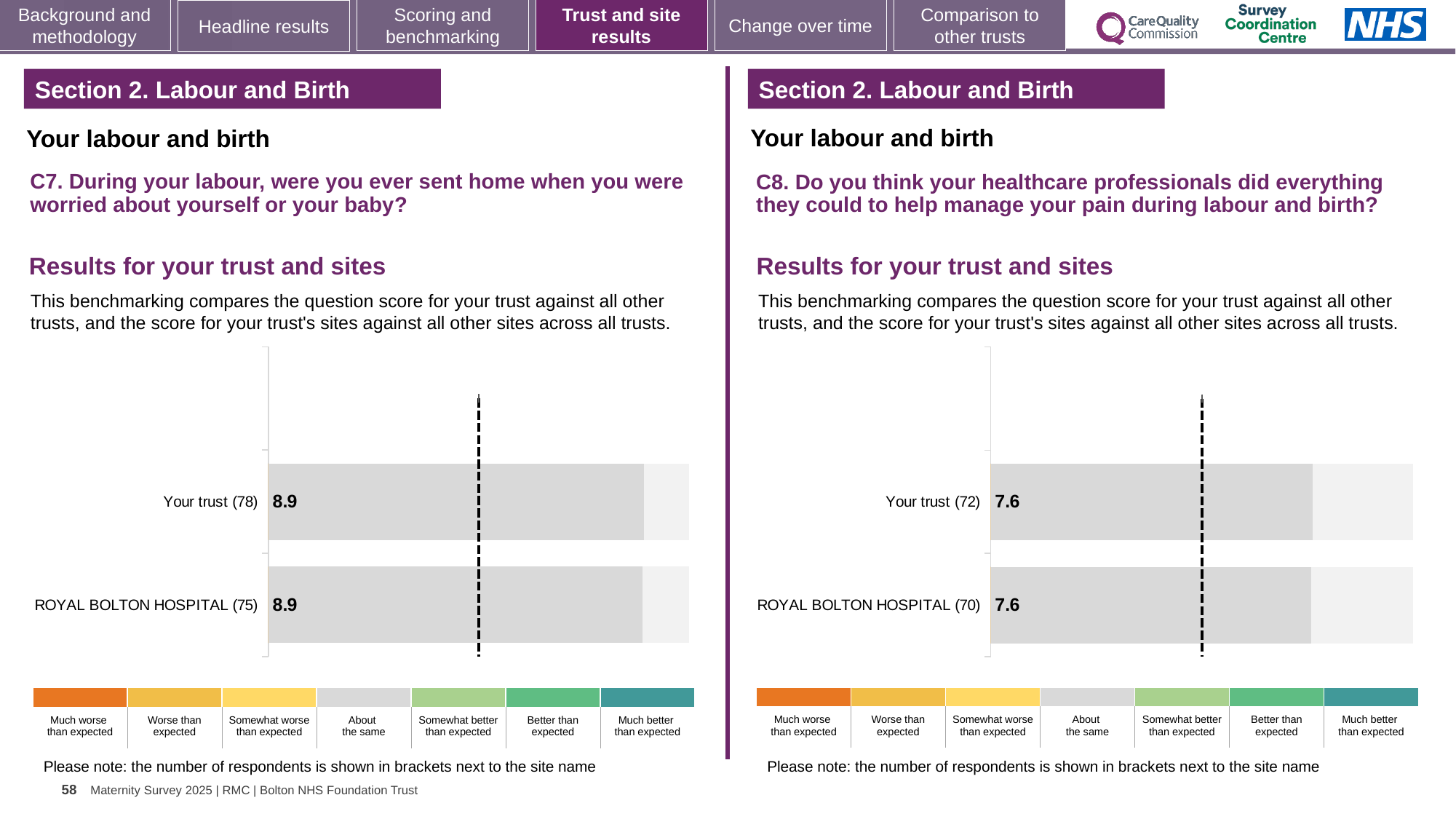
In the C8 chart on the right, what is the difference between the Your trust score and the ROYAL BOLTON HOSPITAL score? 0 How many bars are plotted in the C8 chart on the right? 2 In the C8 chart on the right, what is the score for Your trust? 7.6 In the C8 chart on the right, how many respondents are shown in brackets for Your trust? 72 In the C8 chart on the right, what is the score for ROYAL BOLTON HOSPITAL? 7.6 What type of chart is used for the C7 results on the left? Bar chart In the C7 chart on the left, what is the score for ROYAL BOLTON HOSPITAL? 8.9 In the C7 chart on the left, how many respondents are shown in brackets for ROYAL BOLTON HOSPITAL? 75 In the C7 chart on the left, what is the score for Your trust? 8.9 Is the Your trust score in the C7 chart on the left larger or smaller than the Your trust score in the C8 chart on the right? Larger How many bars are plotted in the C7 chart on the left? 2 In the C7 chart on the left, what is the difference between the Your trust score and the ROYAL BOLTON HOSPITAL score? 0